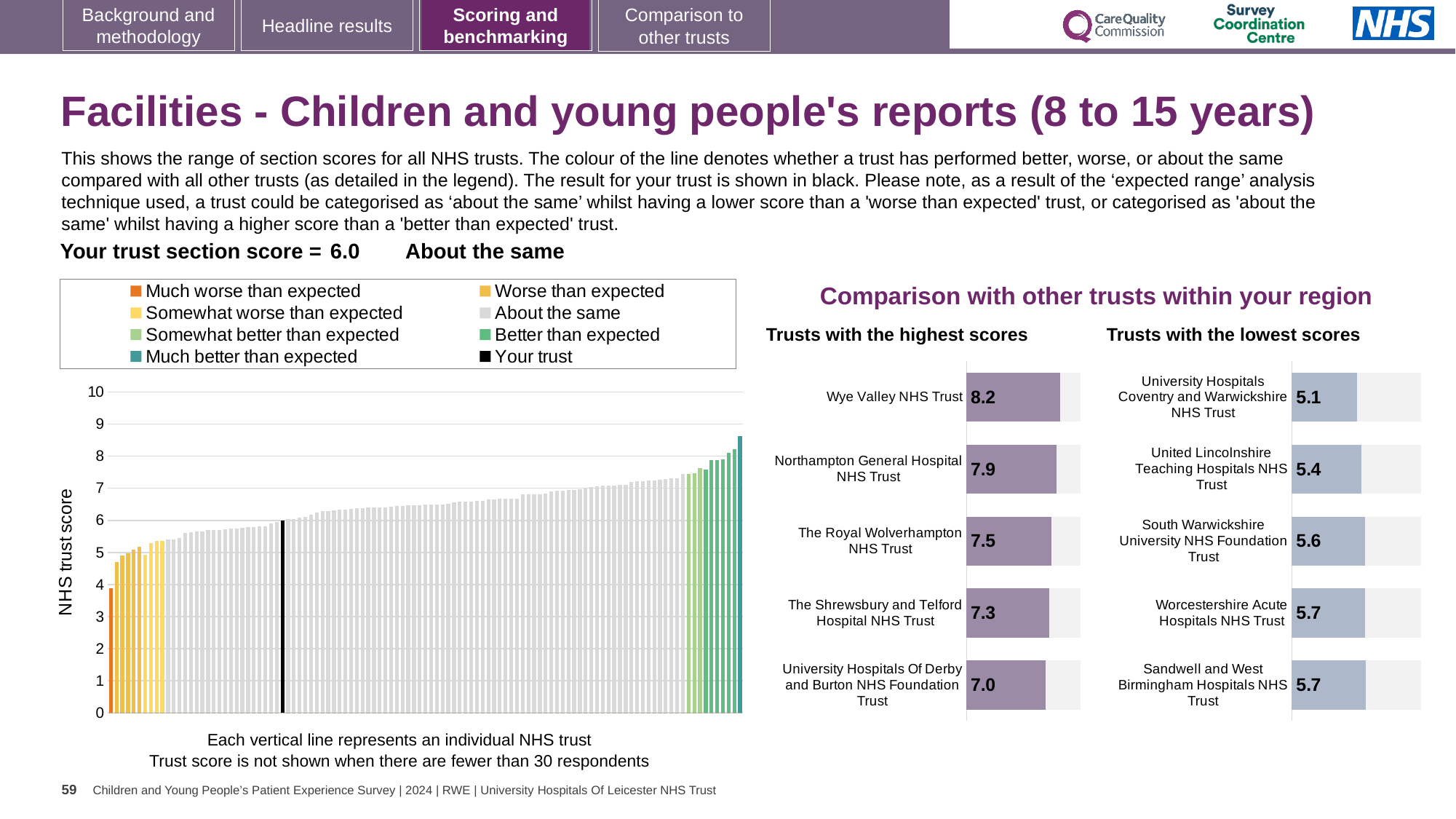
In the 'Trusts with the highest scores' chart, what is the difference between the scores of Wye Valley NHS Trust and University Hospitals Of Derby and Burton NHS Foundation Trust? 1.2 How many trusts are listed in the 'Trusts with the lowest scores' chart? 5 In the 'Trusts with the highest scores' chart, which trust has the highest score? Wye Valley NHS Trust In the 'Trusts with the lowest scores' chart, what is the score for United Lincolnshire Teaching Hospitals NHS Trust? 5.4 In the 'Trusts with the highest scores' chart, which has the higher score: Northampton General Hospital NHS Trust or The Shrewsbury and Telford Hospital NHS Trust? Northampton General Hospital NHS Trust How many entries does the legend of the NHS trust score chart on the left list? 8 In the NHS trust score chart on the left, is the value of the tallest bar greater or less than 8? greater In the 'Trusts with the highest scores' chart, what is the score for Wye Valley NHS Trust? 8.2 In the NHS trust score chart on the left, what is the section score for your trust (the black bar)? 6.0 In the 'Trusts with the lowest scores' chart, what is the difference between the scores of Worcestershire Acute Hospitals NHS Trust and University Hospitals Coventry and Warwickshire NHS Trust? 0.6 In the 'Trusts with the lowest scores' chart, which trust has the lowest score? University Hospitals Coventry and Warwickshire NHS Trust In the 'Trusts with the highest scores' chart, what is the score for The Royal Wolverhampton NHS Trust? 7.5